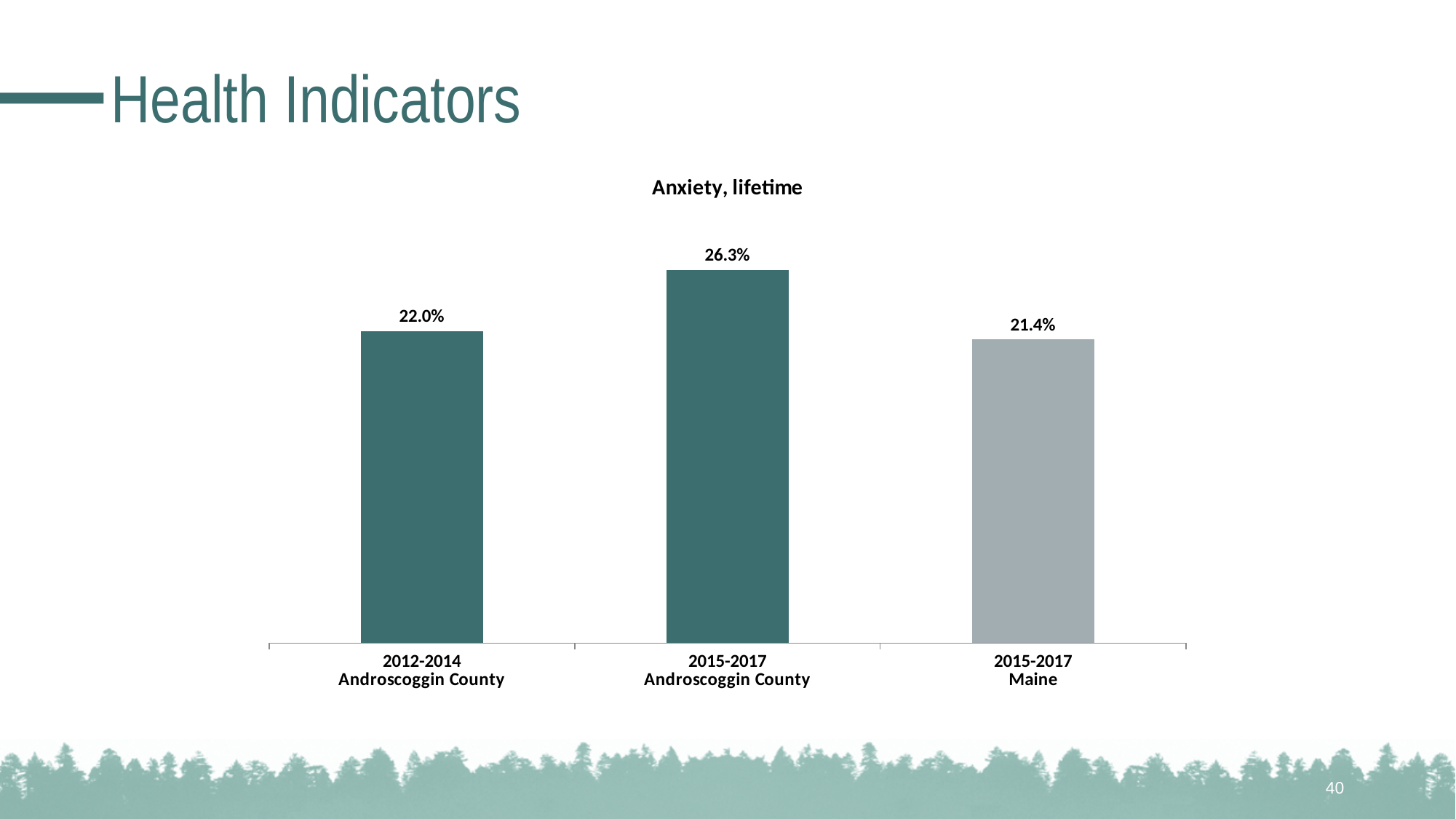
What is the value for 2015-2017 Androscoggin County? 26.3% Which is larger, the value for 2015-2017 Androscoggin County or the value for 2015-2017 Maine? 2015-2017 Androscoggin County What is the title of the chart? Anxiety, lifetime How many bars are shown in the chart? 3 What kind of chart is shown on the slide? Bar chart What is the difference between the 2015-2017 Androscoggin County value and the 2015-2017 Maine value? 4.9% What is the value for 2015-2017 Maine? 21.4% What is the difference between the 2015-2017 Androscoggin County value and the 2012-2014 Androscoggin County value? 4.3% Which category has the highest value? 2015-2017 Androscoggin County What is the value for 2012-2014 Androscoggin County? 22.0% Which category has the lowest value? 2015-2017 Maine Did the Androscoggin County value rise or fall from 2012-2014 to 2015-2017? Rise